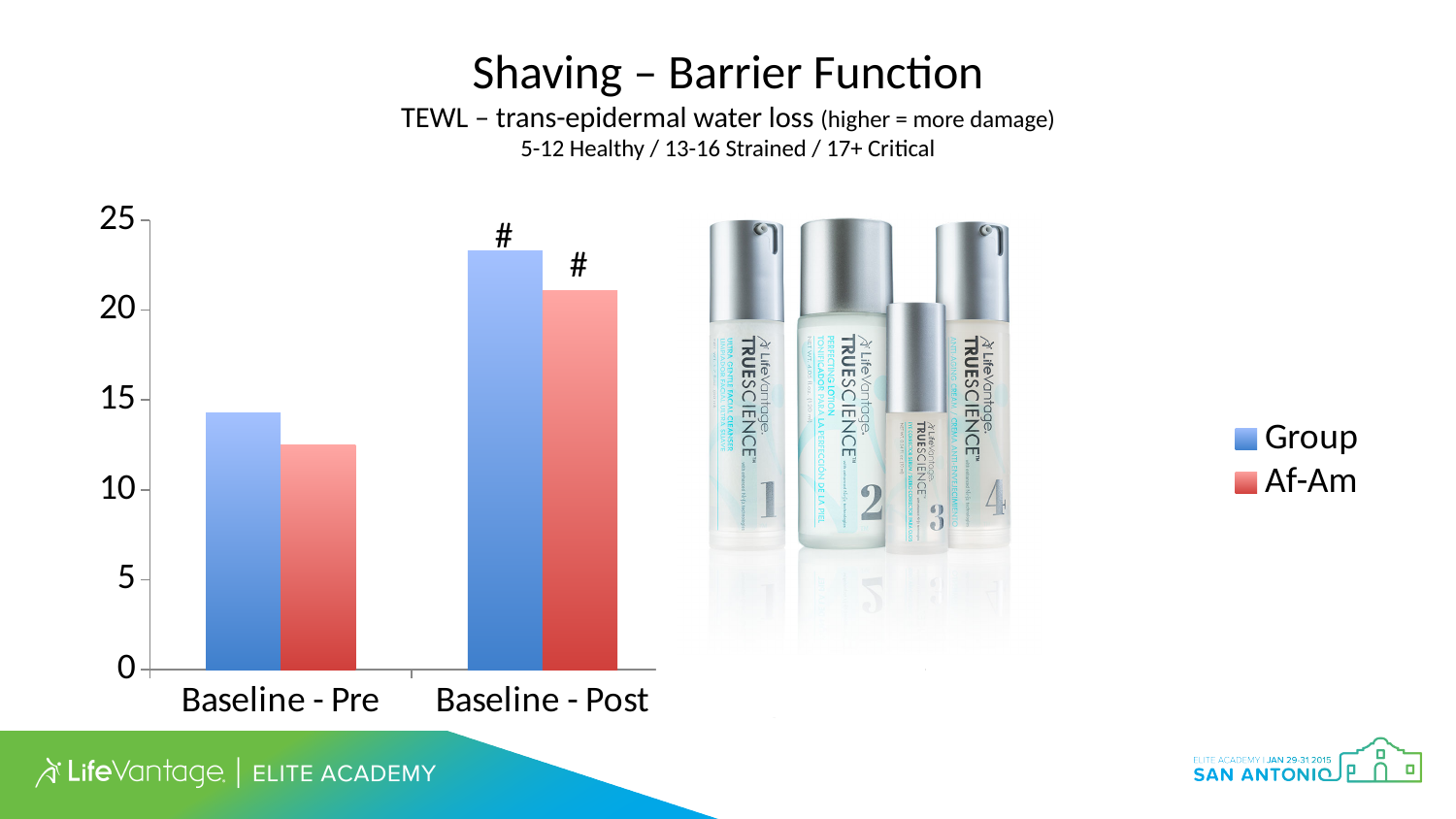
Which is larger, the Group value at Baseline - Pre or the Group value at Baseline - Post? Baseline - Post Which bar is the highest in the chart? Group at Baseline - Post Do the values for the Af-Am series rise or fall from Baseline - Pre to Baseline - Post? rise What kind of chart is shown on the slide? bar chart Which series is shown in red in the chart? Af-Am Is the value for Af-Am at Baseline - Post greater or less than 20? greater How many categories are shown on the x axis of the chart? 2 Is the value for Group at Baseline - Post greater or less than 20? greater Which series is shown in blue in the chart? Group How many series does the chart legend list? 2 Is the value for Af-Am at Baseline - Pre greater or less than 15? less